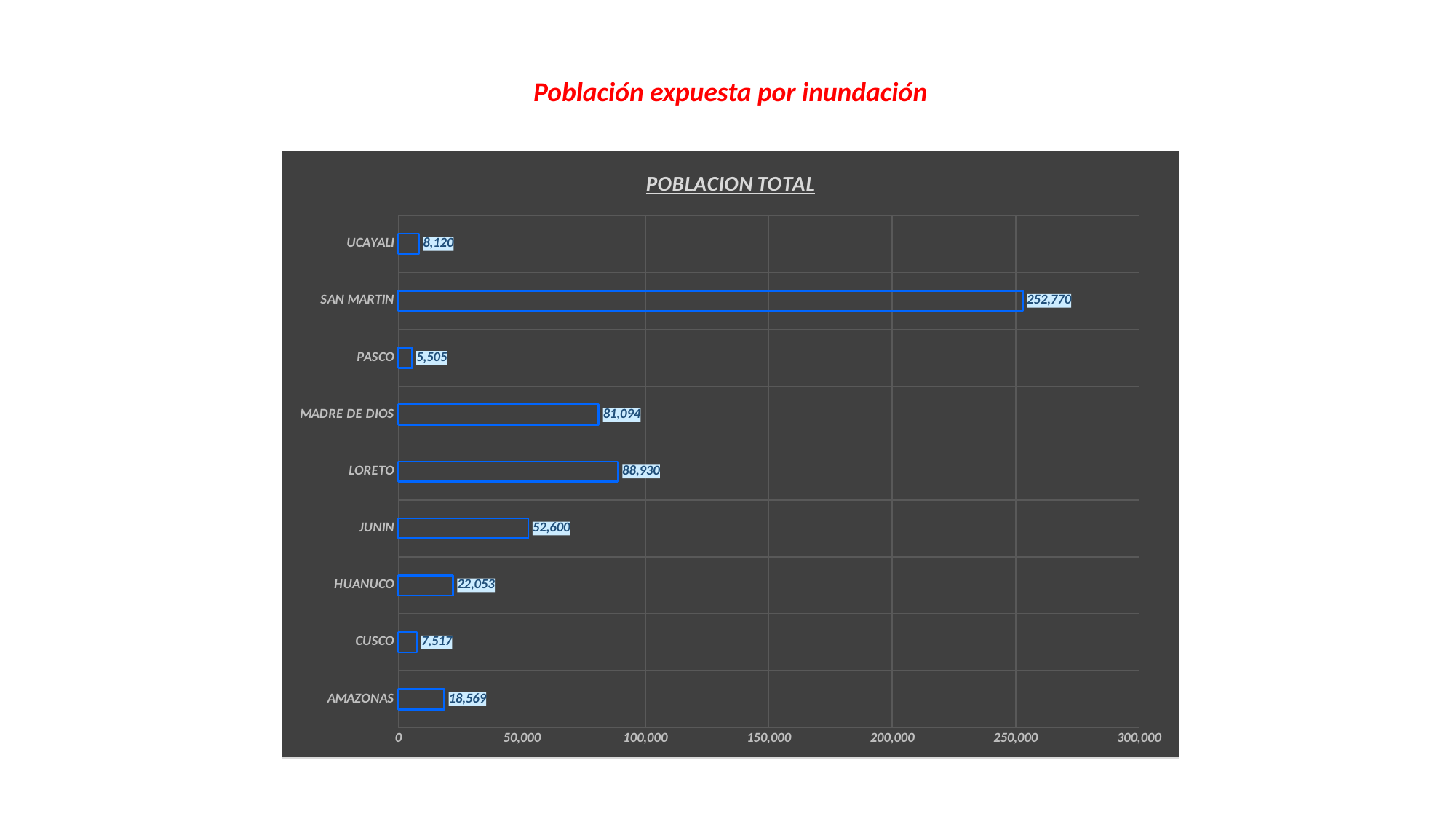
Which category has the highest value? SAN MARTIN How many categories are shown in the chart? 9 What is the difference between the values for LORETO and MADRE DE DIOS? 7,836 What is the difference between the values for UCAYALI and CUSCO? 603 Which category has the lowest value? PASCO What kind of chart is shown on the slide? bar chart What is the value for LORETO? 88,930 What is the value for AMAZONAS? 18,569 What is the value for SAN MARTIN? 252,770 Which is larger, the value for JUNIN or the value for HUANUCO? JUNIN What is the title of the chart? POBLACION TOTAL Is the value for MADRE DE DIOS greater or less than 100,000? less